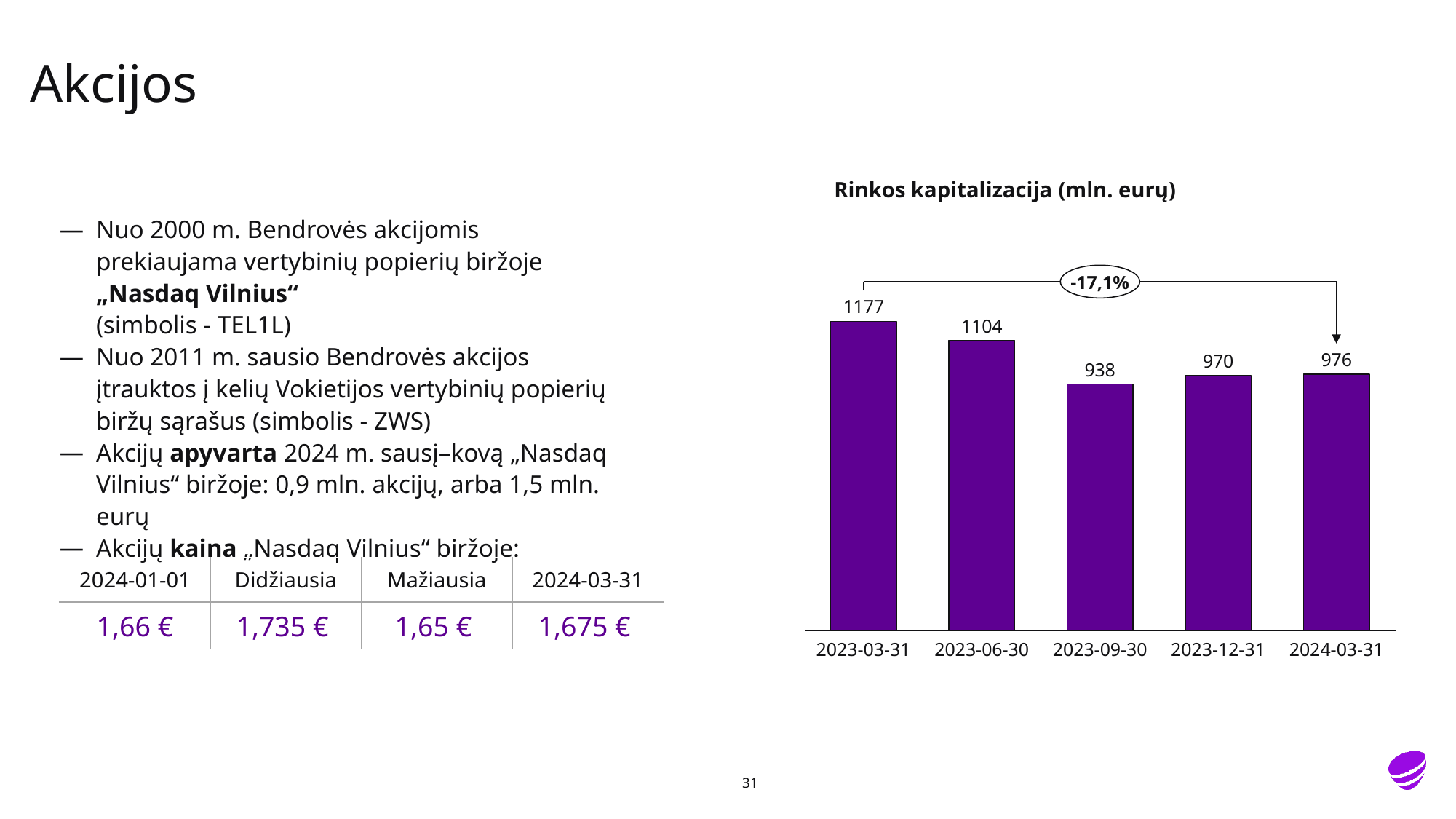
What kind of chart is used to show market capitalisation? bar chart What is the title of the chart on the slide? Rinkos kapitalizacija (mln. eurų) What is the market capitalisation value shown for 2024-03-31? 976 What is the market capitalisation value shown for 2023-09-30? 938 What percentage change is annotated between 2023-03-31 and 2024-03-31 in the chart? -17,1% What is the difference between the market capitalisation on 2023-03-31 and on 2024-03-31? 201 What is the difference between the market capitalisation on 2023-06-30 and on 2023-09-30? 166 What is the market capitalisation value shown for 2023-03-31? 1177 How many dates are shown on the x axis of the chart? 5 Which is larger, the market capitalisation on 2023-12-31 or on 2023-06-30? 2023-06-30 Which date has the highest market capitalisation in the chart? 2023-03-31 Which date has the lowest market capitalisation in the chart? 2023-09-30